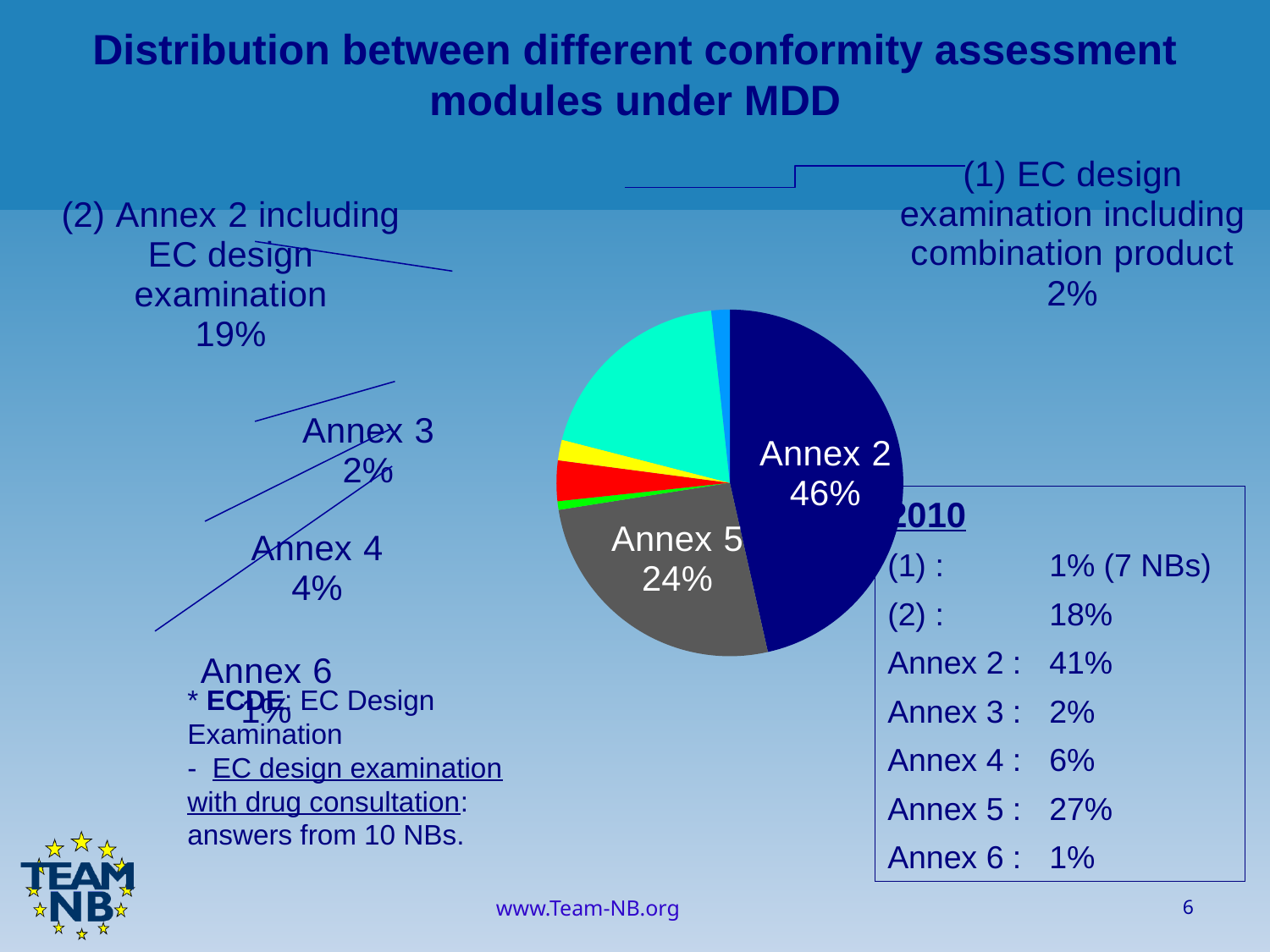
What percentage is shown for Annex 4? 4% What percentage is shown for '(1) EC design examination including combination product'? 2% Which slice of the pie is the smallest? Annex 6 What share of the pie does Annex 2 represent? 46% What is the difference in percentage points between Annex 2 and Annex 5? 22 What share of the pie does Annex 5 represent? 24% How many slices does the pie chart have? 7 Which slice of the pie is the largest? Annex 2 What percentage is shown for '(2) Annex 2 including EC design examination'? 19% What percentage is shown for Annex 6? 1% What kind of chart is shown on the slide? pie chart Which is larger, the Annex 4 slice or the Annex 3 slice? Annex 4